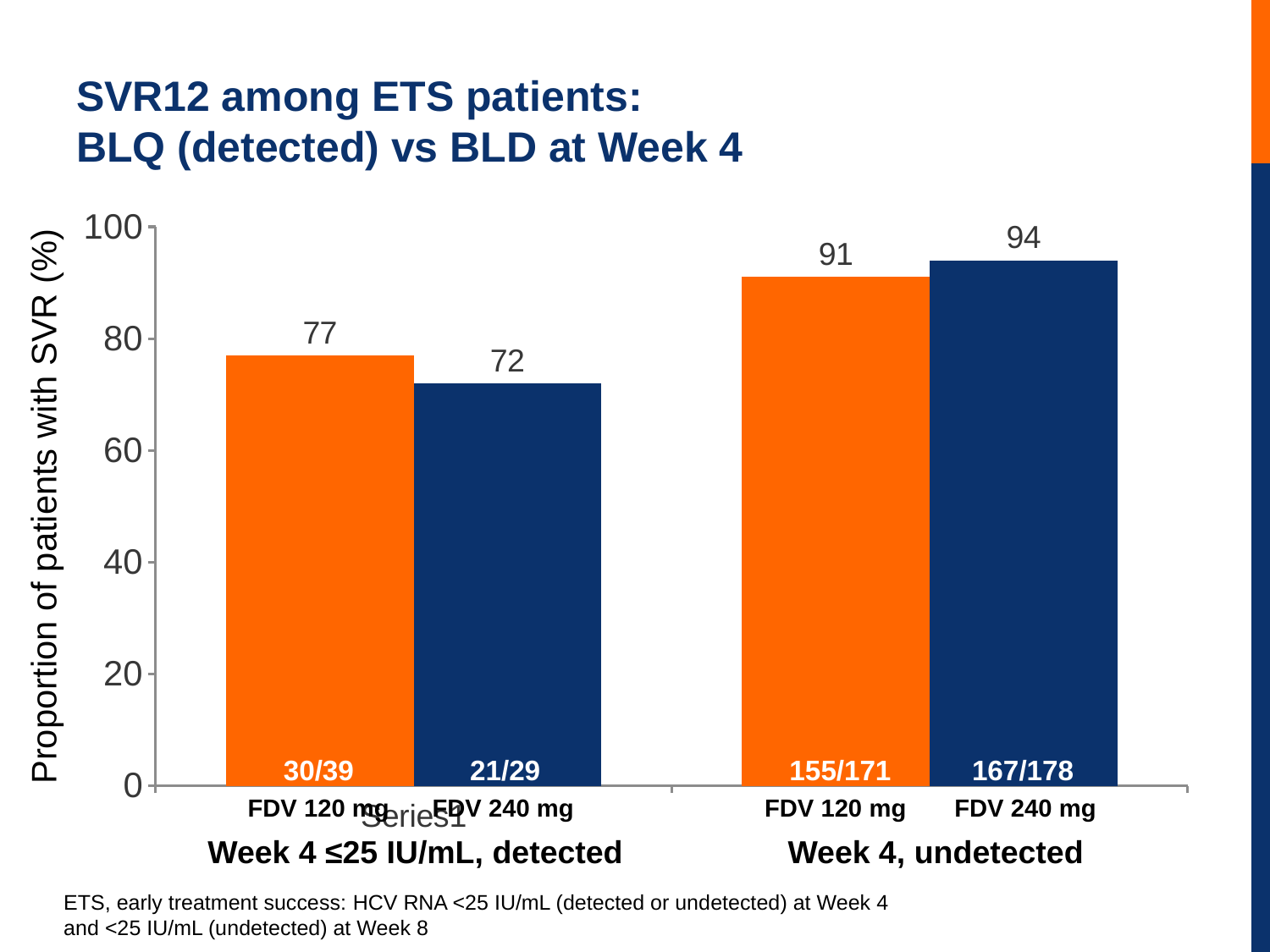
Which bar has the lowest SVR12 rate? FDV 240 mg, Week 4 ≤25 IU/mL, detected What is the difference in SVR12 rate between FDV 120 mg and FDV 240 mg in the Week 4 ≤25 IU/mL, detected group? 5 What kind of chart is shown on the slide? Bar chart What is the difference in SVR12 rate between FDV 240 mg and FDV 120 mg in the Week 4, undetected group? 3 What fraction of patients is printed on the FDV 120 mg bar in the Week 4, undetected group? 155/171 Which bar has the highest SVR12 rate? FDV 240 mg, Week 4, undetected What is the SVR12 rate for FDV 240 mg in the Week 4, undetected group? 94 How many bars are plotted in the chart? 4 Which is larger: the SVR12 rate for FDV 120 mg in the detected group or for FDV 120 mg in the undetected group? FDV 120 mg in the undetected group What is the label of the y axis? Proportion of patients with SVR (%) What is the SVR12 rate for FDV 240 mg in the Week 4 ≤25 IU/mL, detected group? 72 What is the SVR12 rate for FDV 120 mg in the Week 4 ≤25 IU/mL, detected group? 77